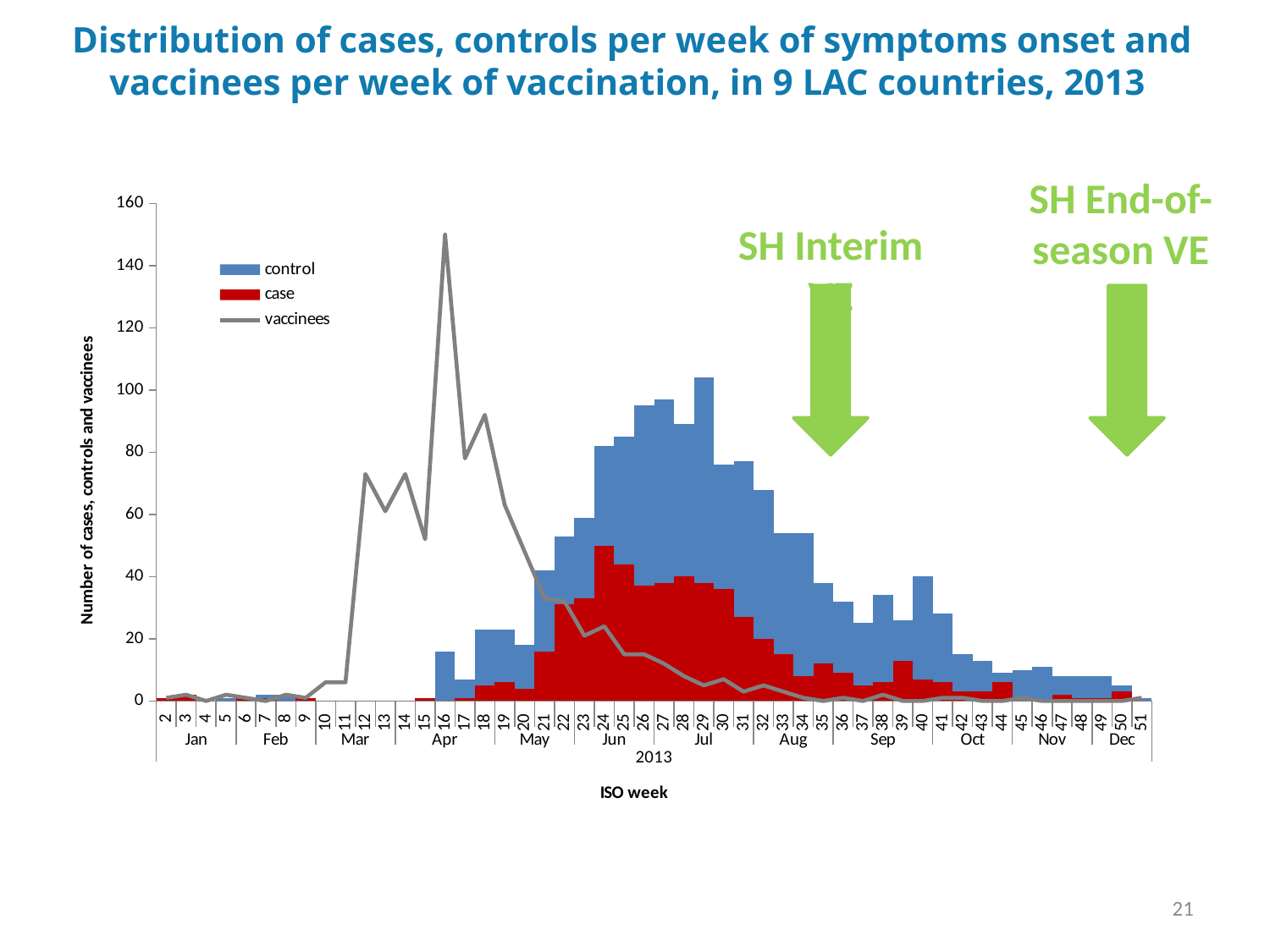
What kind of chart is shown on the slide? A bar chart combined with a line Which is larger, the vaccinees value at week 16 or at week 12? Week 16 What are the three series named in the legend? control, case, vaccinees How many series does the legend list? 3 Which is larger, the case value at week 24 or at week 40? Week 24 Is the case value at week 24 greater or less than 40? greater In which ISO week is the total stacked bar (cases plus controls) the tallest? Week 29 Does the vaccinees line rise or fall from week 16 to week 51? Fall Is the total stacked bar at week 29 greater or less than 100? greater Is the peak value of the vaccinees line at week 16 greater or less than 140? greater In which ISO week does the vaccinees line reach its highest value? Week 16 What is the label of the vertical axis? Number of cases, controls and vaccinees